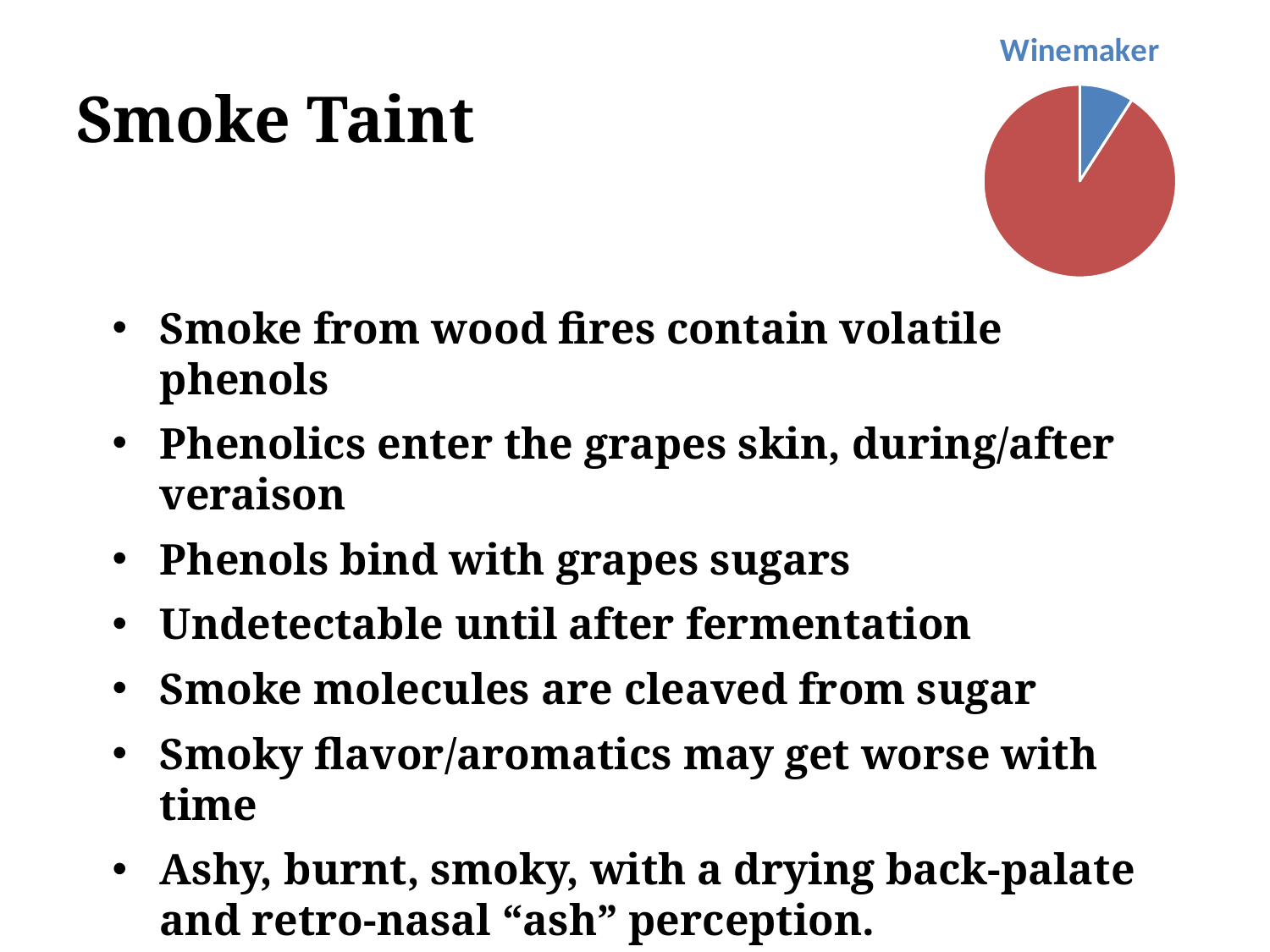
Which slice of the pie chart is larger, the blue one or the red one? the red one What two colours are used for the slices of the pie chart? blue and red How many slices does the pie chart have? 2 What is the title of the pie chart? Winemaker What kind of chart is shown on the slide? pie chart Which slice of the pie chart is the smallest? the blue slice Which slice of the pie chart is the largest? the red slice